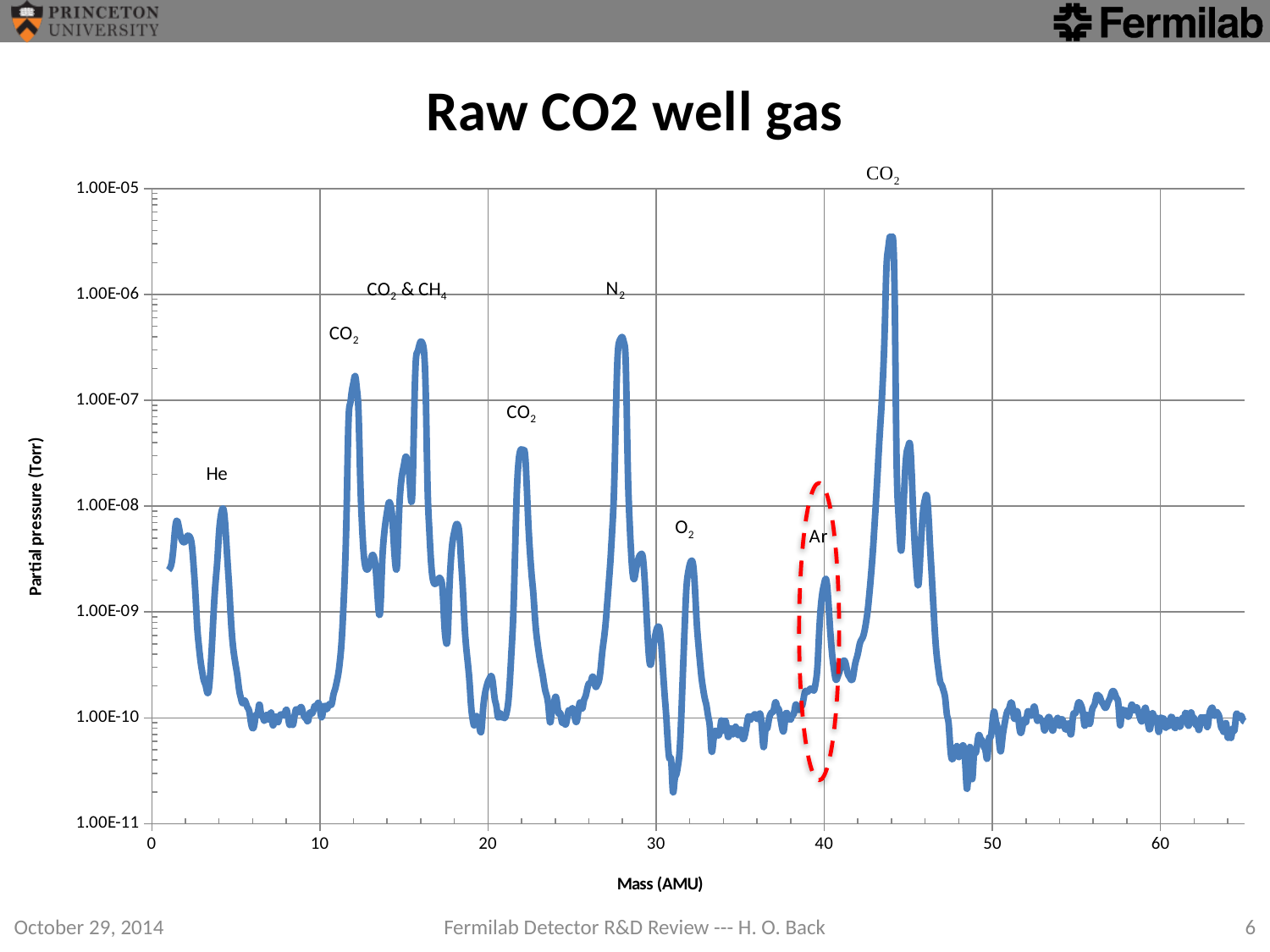
What kind of chart is shown on the slide? line chart Is the N2 peak greater or less than 1.00E-07 Torr? greater How many labeled peaks are annotated on the chart? 8 Which peak is highlighted with a red dashed ellipse? Ar Which labeled peak is the lowest in the chart? Ar Is the O2 peak greater or less than 1.00E-09 Torr? greater Is the Ar peak greater or less than 1.00E-08 Torr? less Which peak is larger, N2 or O2? N2 Which labeled peak is the highest in the chart? CO2 (near 44 AMU) What is the title of the chart? Raw CO2 well gas